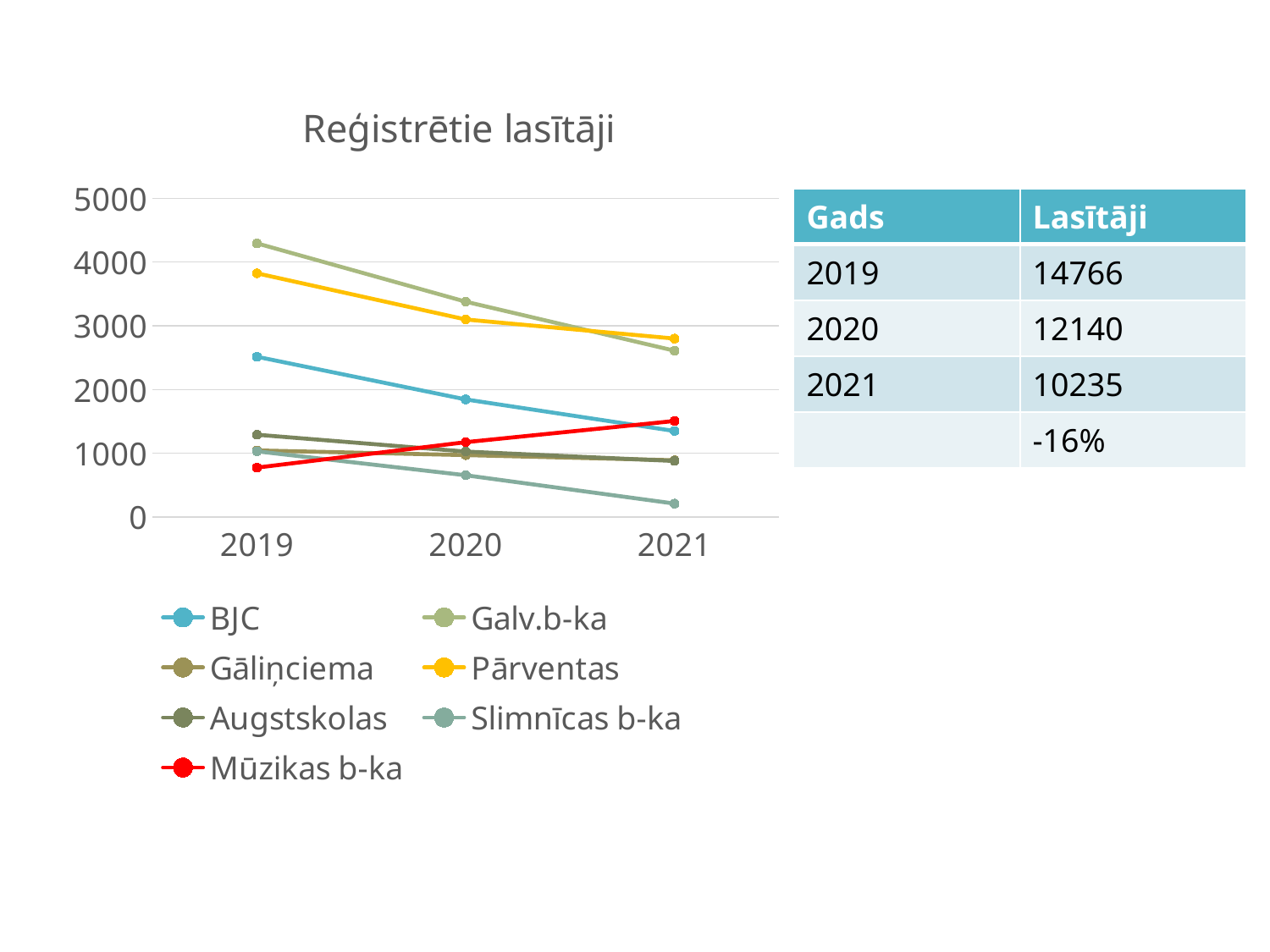
How many years are plotted along the x axis of the chart? 3 Does the Mūzikas b-ka series rise or fall from 2019 to 2021? rise What is the title of the chart? Reģistrētie lasītāji Is the value for Slimnīcas b-ka in 2021 greater or less than 1000? less Which series is drawn with the red line? Mūzikas b-ka Is the value for Galv.b-ka in 2019 greater or less than 4000? greater Which is larger in 2019, the value for BJC or the value for Pārventas? Pārventas What kind of chart is shown on the slide? line chart Is the value for BJC in 2019 greater or less than 2000? greater Which series has the highest value in 2019? Galv.b-ka Which series has the lowest value in 2021? Slimnīcas b-ka How many series does the chart legend list? 7